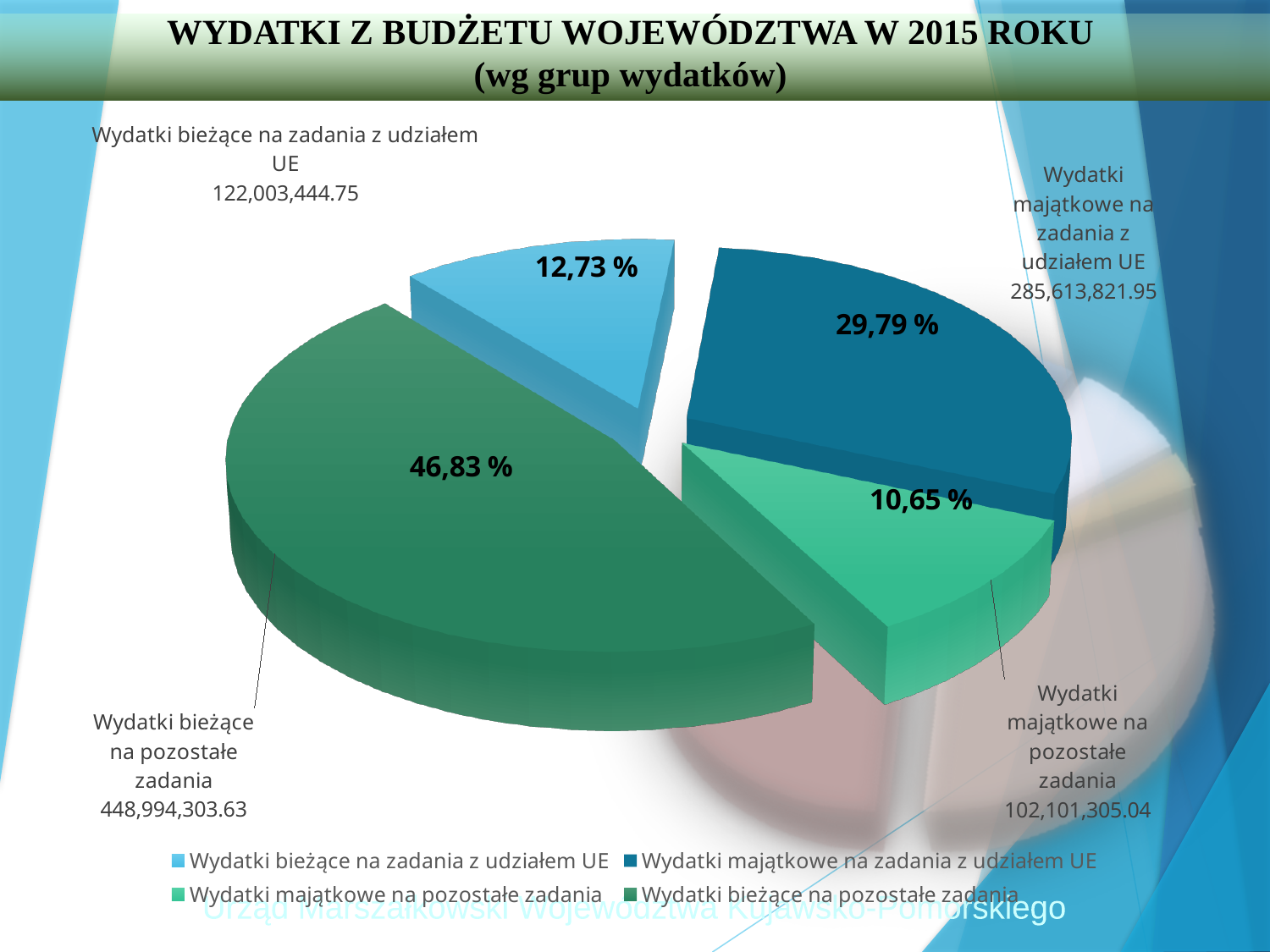
Which category has the largest slice? Wydatki bieżące na pozostałe zadania Which is larger: Wydatki majątkowe na zadania z udziałem UE or Wydatki bieżące na zadania z udziałem UE? Wydatki majątkowe na zadania z udziałem UE What is the value for Wydatki bieżące na zadania z udziałem UE? 122,003,444.75 Which category has the smallest slice? Wydatki majątkowe na pozostałe zadania What kind of chart is shown on the slide? pie chart What percentage share does Wydatki bieżące na pozostałe zadania have? 46,83 % What percentage share does Wydatki majątkowe na pozostałe zadania have? 10,65 % How many slices does the pie chart have? 4 What is the difference in percentage share between Wydatki bieżące na pozostałe zadania and Wydatki majątkowe na zadania z udziałem UE? 17,04 % What is the value for Wydatki majątkowe na pozostałe zadania? 102,101,305.04 What is the value for Wydatki majątkowe na zadania z udziałem UE? 285,613,821.95 How many entries does the legend list? 4